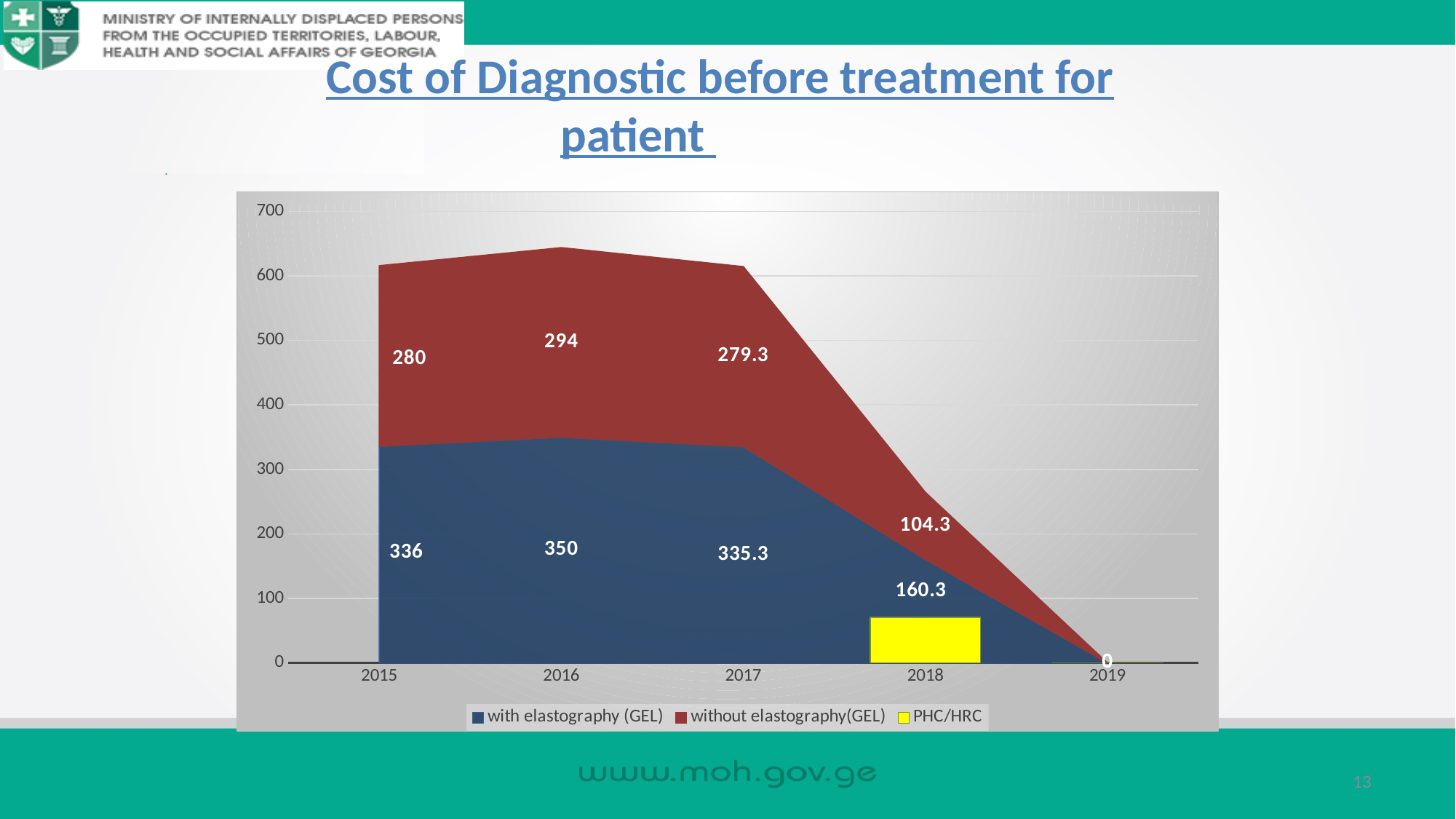
Is the PHC/HRC value for 2018 greater or less than 100? less Does the 'with elastography (GEL)' value rise or fall from 2017 to 2019? fall What is the value for 'with elastography (GEL)' in 2018? 160.3 In which year is the 'with elastography (GEL)' value highest? 2016 How many years are shown on the x axis? 5 What is the value for 'with elastography (GEL)' in 2016? 350 What is the combined total of 'with elastography (GEL)' and 'without elastography(GEL)' in 2015? 616 What is the value for 'without elastography(GEL)' in 2017? 279.3 What is the value for 'without elastography(GEL)' in 2015? 280 What is the difference between the 'with elastography (GEL)' values for 2016 and 2015? 14 In 2017, which is larger: 'with elastography (GEL)' or 'without elastography(GEL)'? with elastography (GEL) How many series does the legend list? 3